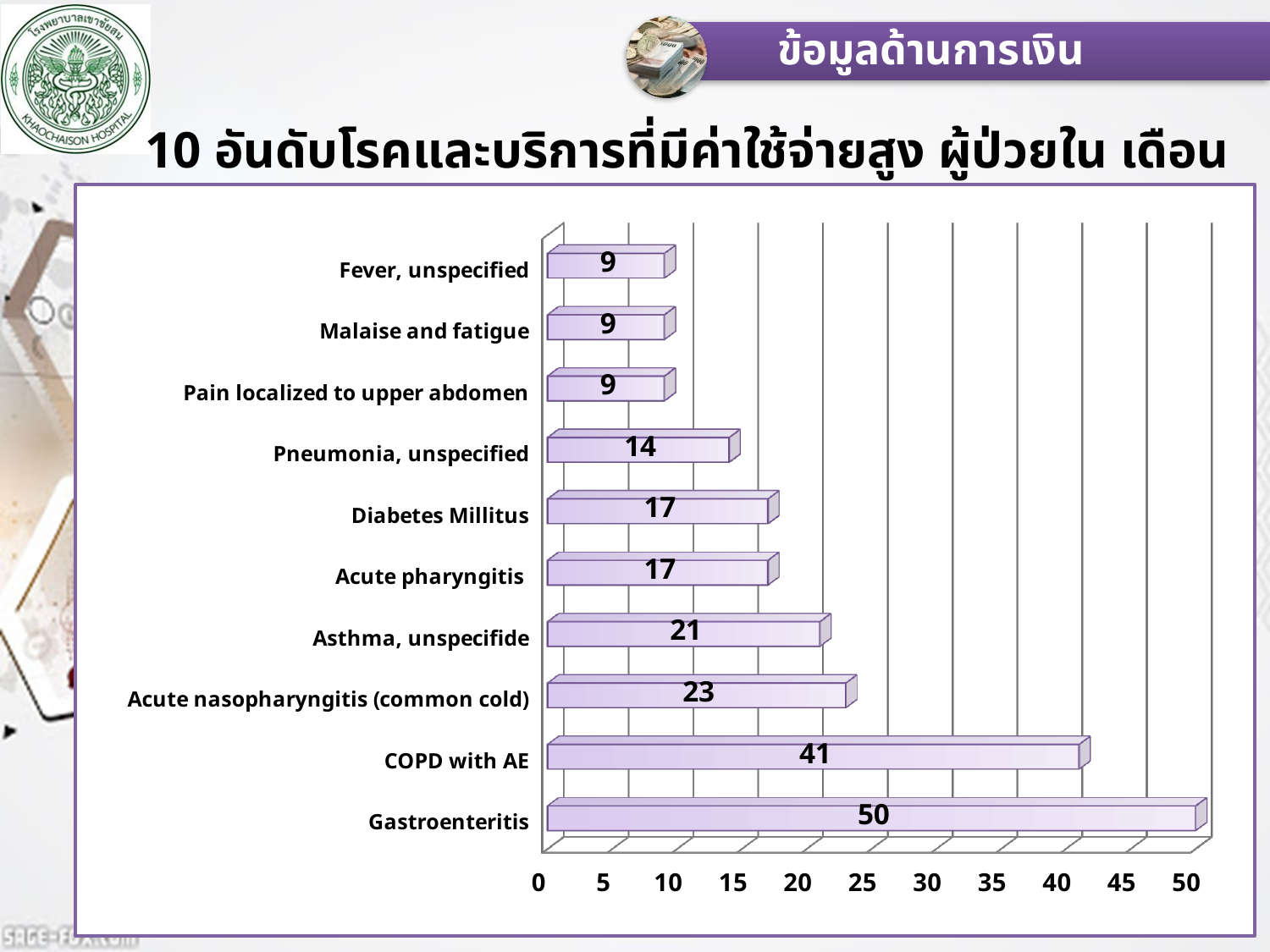
What is the difference between the values for Acute nasopharyngitis (common cold) and Asthma, unspecifide? 2 Which is larger, the value for Asthma, unspecifide or the value for Diabetes Millitus? Asthma, unspecifide Which category has the highest value? Gastroenteritis What kind of chart is shown on the slide? bar chart What is the difference between the values for Gastroenteritis and COPD with AE? 9 How many categories are shown in the chart? 10 How many categories have a value of 9? 3 What is the value for Pneumonia, unspecified? 14 What is the value for COPD with AE? 41 What is the value for Acute nasopharyngitis (common cold)? 23 What is the value for Gastroenteritis? 50 Is the value for COPD with AE greater or less than 40? greater